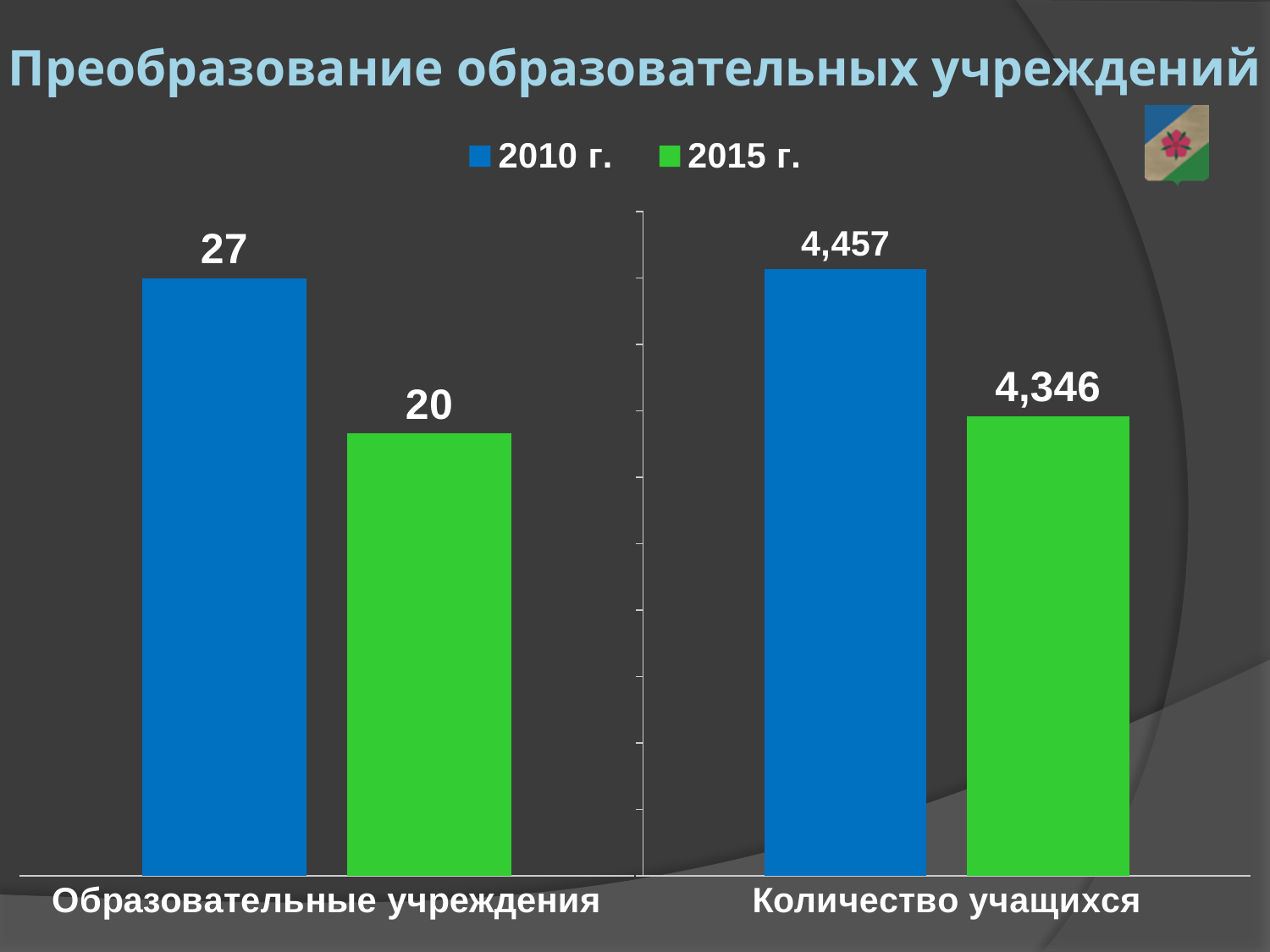
In the left chart (Образовательные учреждения), what is the difference between the 2010 г. and 2015 г. values? 7 In the left chart (Образовательные учреждения), what is the value for 2010 г.? 27 In the right chart (Количество учащихся), do the values rise or fall from 2010 г. to 2015 г.? Fall In the left chart (Образовательные учреждения), what is the value for 2015 г.? 20 What kind of chart is shown on the slide? Bar chart What colour represents 2015 г. in the legend? Green How many series does the legend list? 2 In the right chart (Количество учащихся), what is the value for 2010 г.? 4,457 In the left chart (Образовательные учреждения), which year has the higher value, 2010 г. or 2015 г.? 2010 г. In the right chart (Количество учащихся), what is the value for 2015 г.? 4,346 In the right chart (Количество учащихся), what is the difference between the 2010 г. and 2015 г. values? 111 In the right chart (Количество учащихся), which year has the lower value? 2015 г.